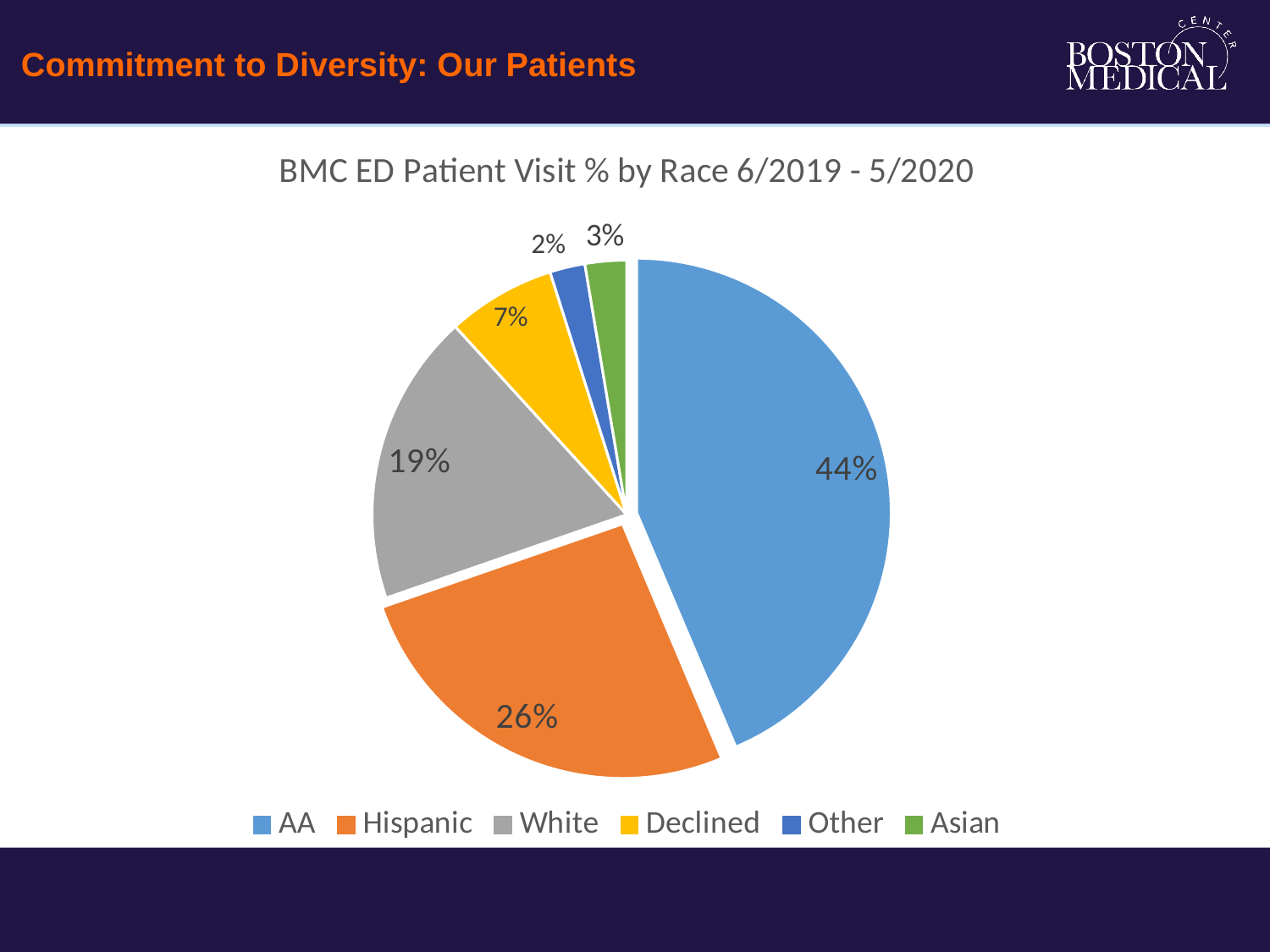
Which slice is larger, White or Declined? White What percentage of ED patient visits is labelled for Declined? 7% What percentage of ED patient visits is labelled for Asian? 3% What kind of chart is shown on the slide? Pie chart How many categories does the legend list? 6 What percentage of ED patient visits is labelled for White? 19% Which category has the smallest slice of the pie? Other What is the difference in percentage points between the AA and Hispanic slices? 18 What percentage of ED patient visits is labelled for Hispanic? 26% What percentage of ED patient visits is labelled for AA? 44% Which category has the largest slice of the pie? AA What is the title of the chart? BMC ED Patient Visit % by Race 6/2019 - 5/2020